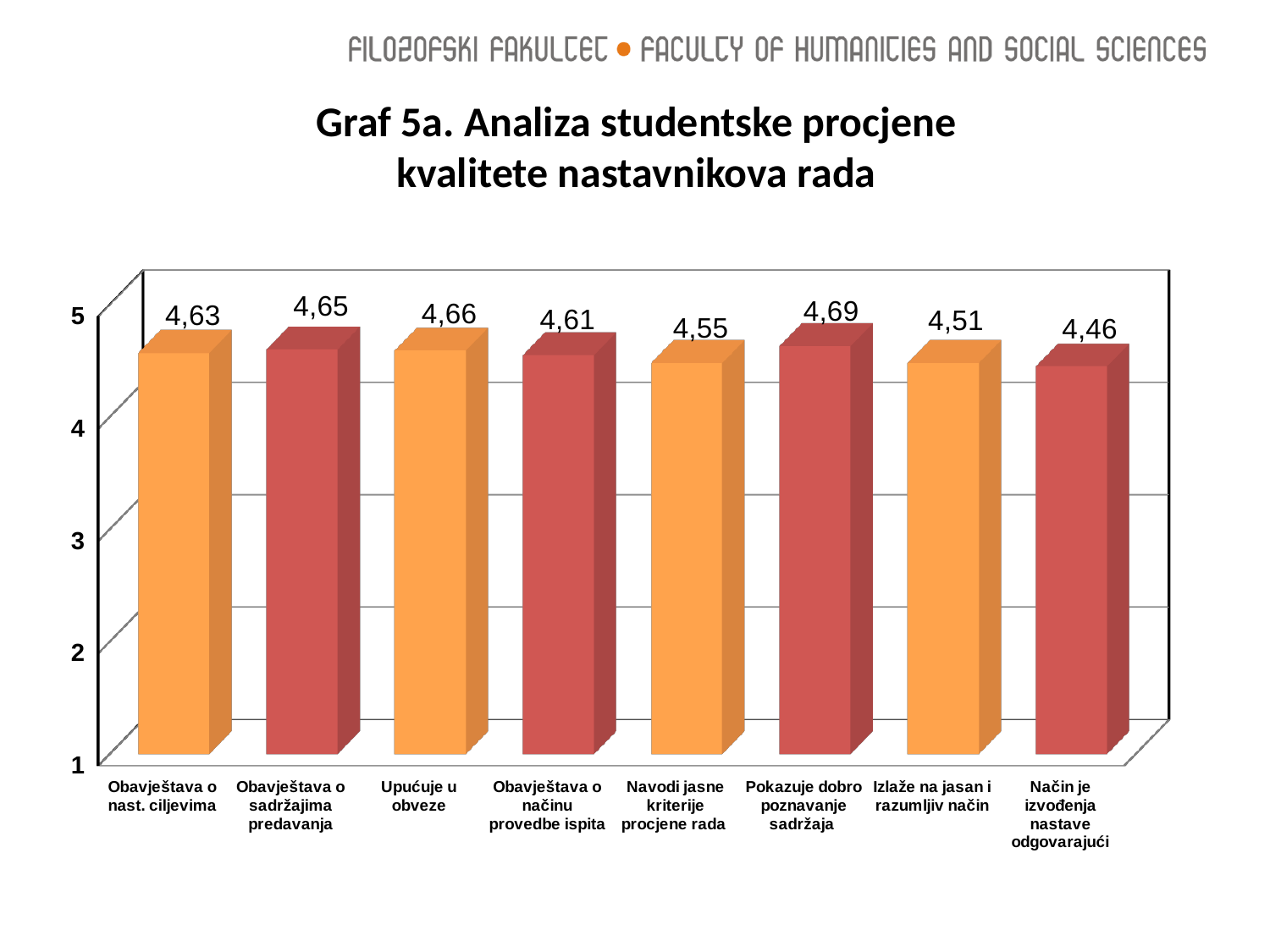
Which category has the highest value? Pokazuje dobro poznavanje sadržaja What is the value for "Navodi jasne kriterije procjene rada"? 4,55 What is the value for "Upućuje u obveze"? 4,66 How many categories are shown in the chart? 8 What is the value for "Način je izvođenja nastave odgovarajući"? 4,46 Which category has the lowest value? Način je izvođenja nastave odgovarajući What is the difference between the values for "Pokazuje dobro poznavanje sadržaja" and "Način je izvođenja nastave odgovarajući"? 0,23 Which is larger: the value for "Obavještava o sadržajima predavanja" or the value for "Obavještava o načinu provedbe ispita"? Obavještava o sadržajima predavanja Is the value for "Izlaže na jasan i razumljiv način" greater or less than 4? greater What is the title of the chart? Graf 5a. Analiza studentske procjene kvalitete nastavnikova rada What kind of chart is shown on the slide? bar chart What is the difference between the values for "Obavještava o nast. ciljevima" and "Izlaže na jasan i razumljiv način"? 0,12